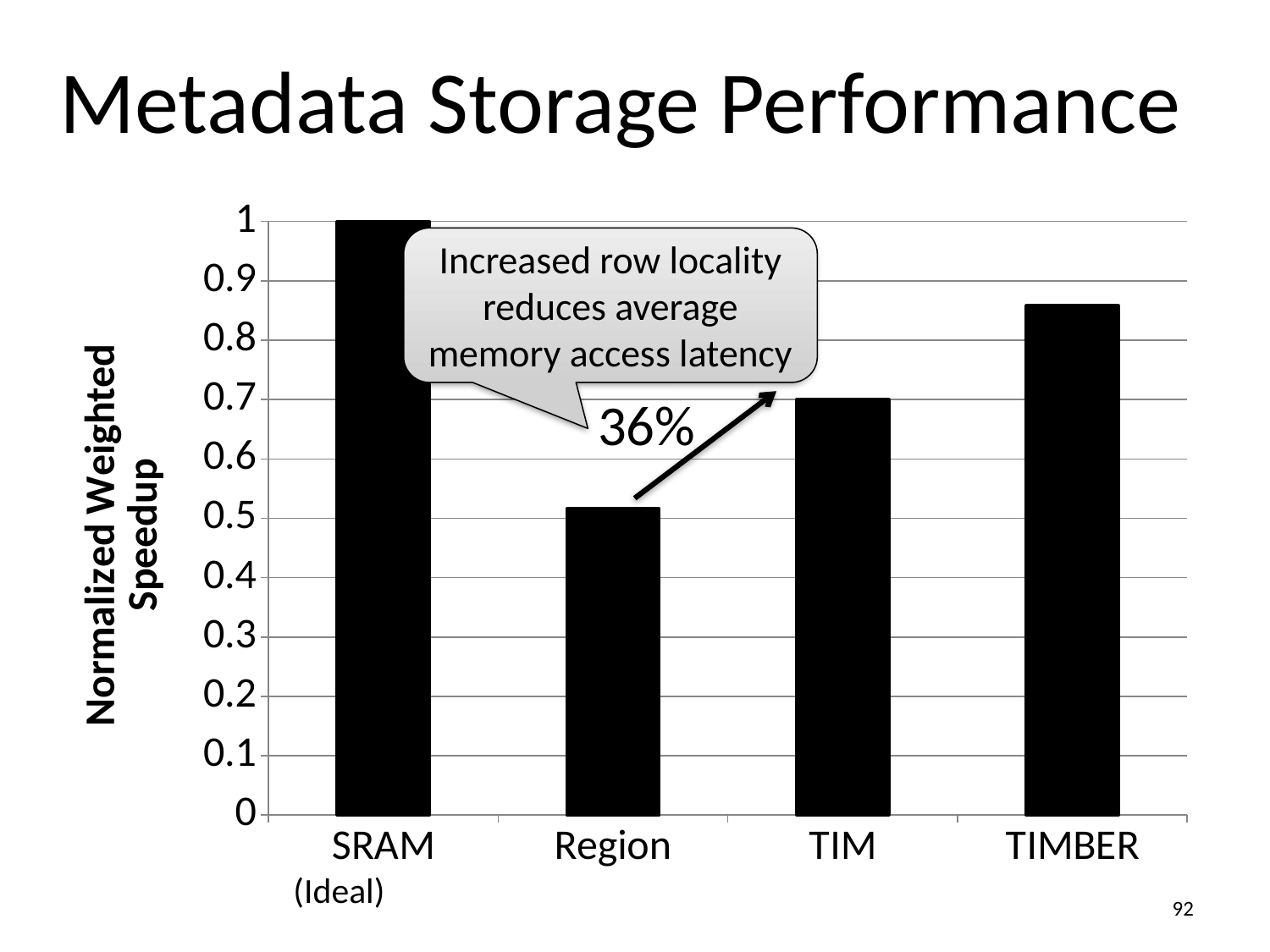
Which has a higher normalized weighted speedup, Region or TIM? TIM What is the normalized weighted speedup for SRAM (Ideal)? 1 How many categories are plotted on the x axis? 4 Is the value for TIMBER greater or less than 0.8? greater Is the value for TIM greater or less than 0.8? less Which has a higher normalized weighted speedup, TIM or TIMBER? TIMBER Which category has the highest normalized weighted speedup? SRAM (Ideal) Is the value for Region greater or less than 0.6? less What percentage improvement is annotated between the Region and TIM bars? 36% What is the label of the y axis? Normalized Weighted Speedup Which category has the lowest normalized weighted speedup? Region What kind of chart is shown on the slide? bar chart